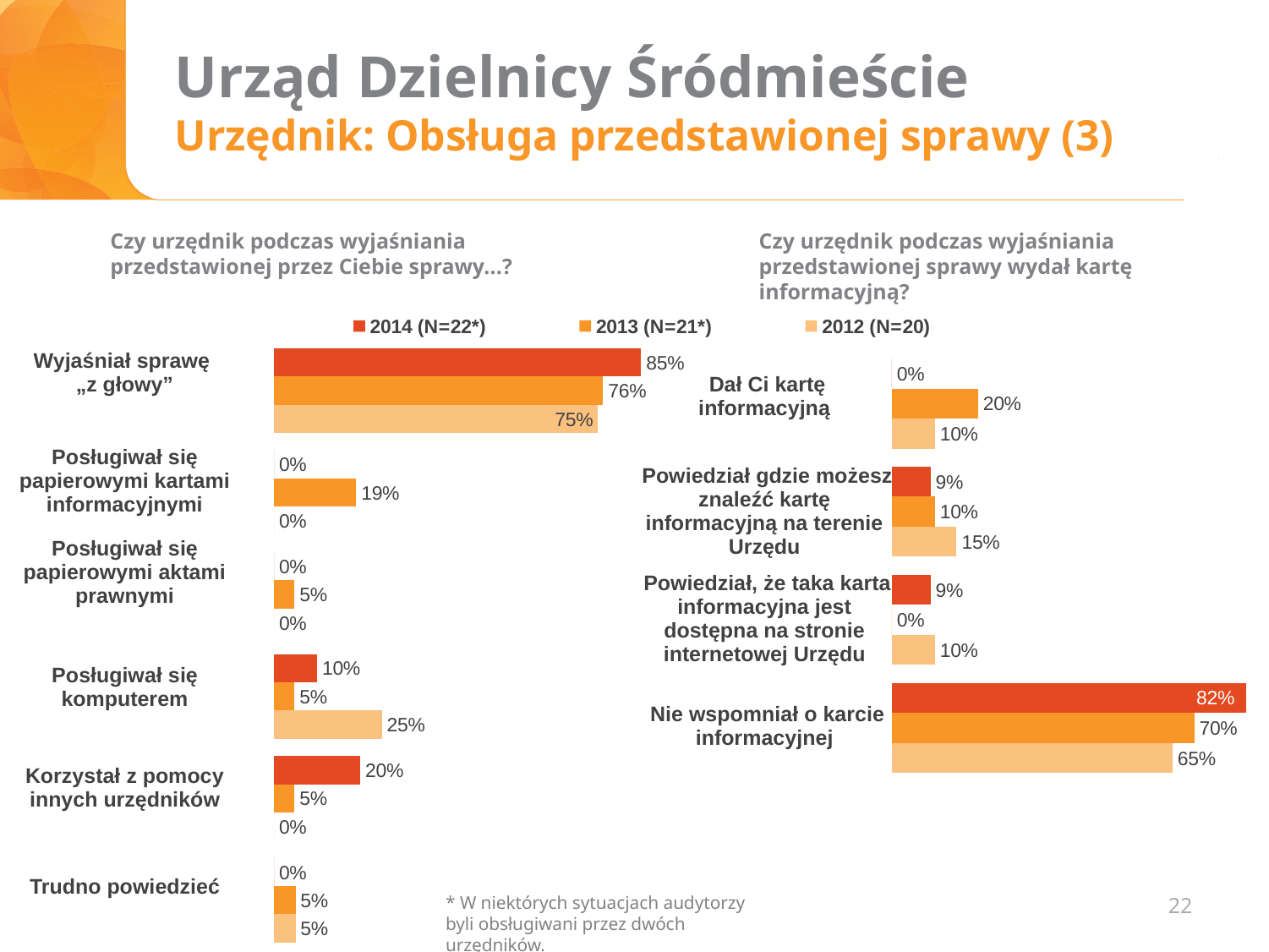
In the right chart ("Czy urzędnik podczas wyjaśniania przedstawionej sprawy wydał kartę informacyjną?"), what is the 2014 value for "Nie wspomniał o karcie informacyjnej"? 82% In the left chart, what is the difference between the 2014 and 2012 values for "Wyjaśniał sprawę „z głowy”"? 10% In the left chart, for "Korzystał z pomocy innych urzędników", which is larger: the 2014 value or the 2013 value? 2014 In the left chart ("Czy urzędnik podczas wyjaśniania przedstawionej przez Ciebie sprawy...?"), what is the 2014 value for "Wyjaśniał sprawę „z głowy”"? 85% In the right chart, what is the difference between the 2013 and 2012 values for "Nie wspomniał o karcie informacyjnej"? 5% In the left chart, which category has the highest 2014 value? Wyjaśniał sprawę „z głowy” In the left chart, what is the 2012 value for "Posługiwał się komputerem"? 25% How many categories does the left chart show? 6 In the right chart, what is the 2013 value for "Dał Ci kartę informacyjną"? 20% What type of chart is the right chart? Bar chart How many series does the legend list? 3 In the left chart, what is the 2013 value for "Posługiwał się papierowymi kartami informacyjnymi"? 19%